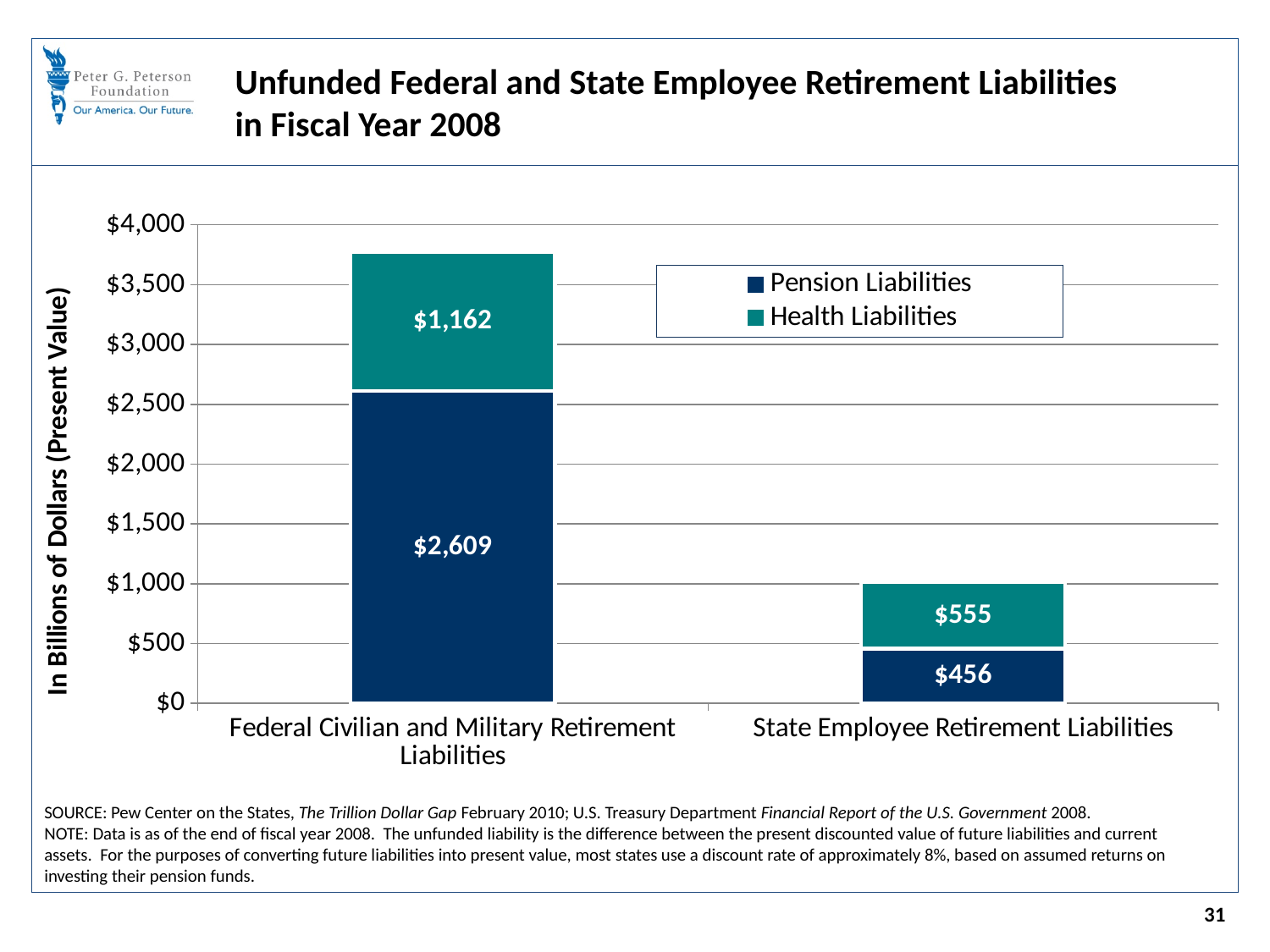
What unit is shown on the vertical axis label? In Billions of Dollars (Present Value) What is the value of Pension Liabilities for Federal Civilian and Military Retirement Liabilities? $2,609 Which category has the higher total unfunded liability? Federal Civilian and Military Retirement Liabilities What is the value of Health Liabilities for Federal Civilian and Military Retirement Liabilities? $1,162 Which is larger for State Employee Retirement Liabilities, Pension Liabilities or Health Liabilities? Health Liabilities How many series does the legend list? 2 What is the difference between Pension Liabilities for Federal Civilian and Military Retirement Liabilities and Pension Liabilities for State Employee Retirement Liabilities? $2,153 What is the total of the stacked bar for State Employee Retirement Liabilities? $1,011 What kind of chart is shown on the slide? Stacked bar chart What is the total of the stacked bar for Federal Civilian and Military Retirement Liabilities? $3,771 What is the value of Health Liabilities for State Employee Retirement Liabilities? $555 What is the value of Pension Liabilities for State Employee Retirement Liabilities? $456